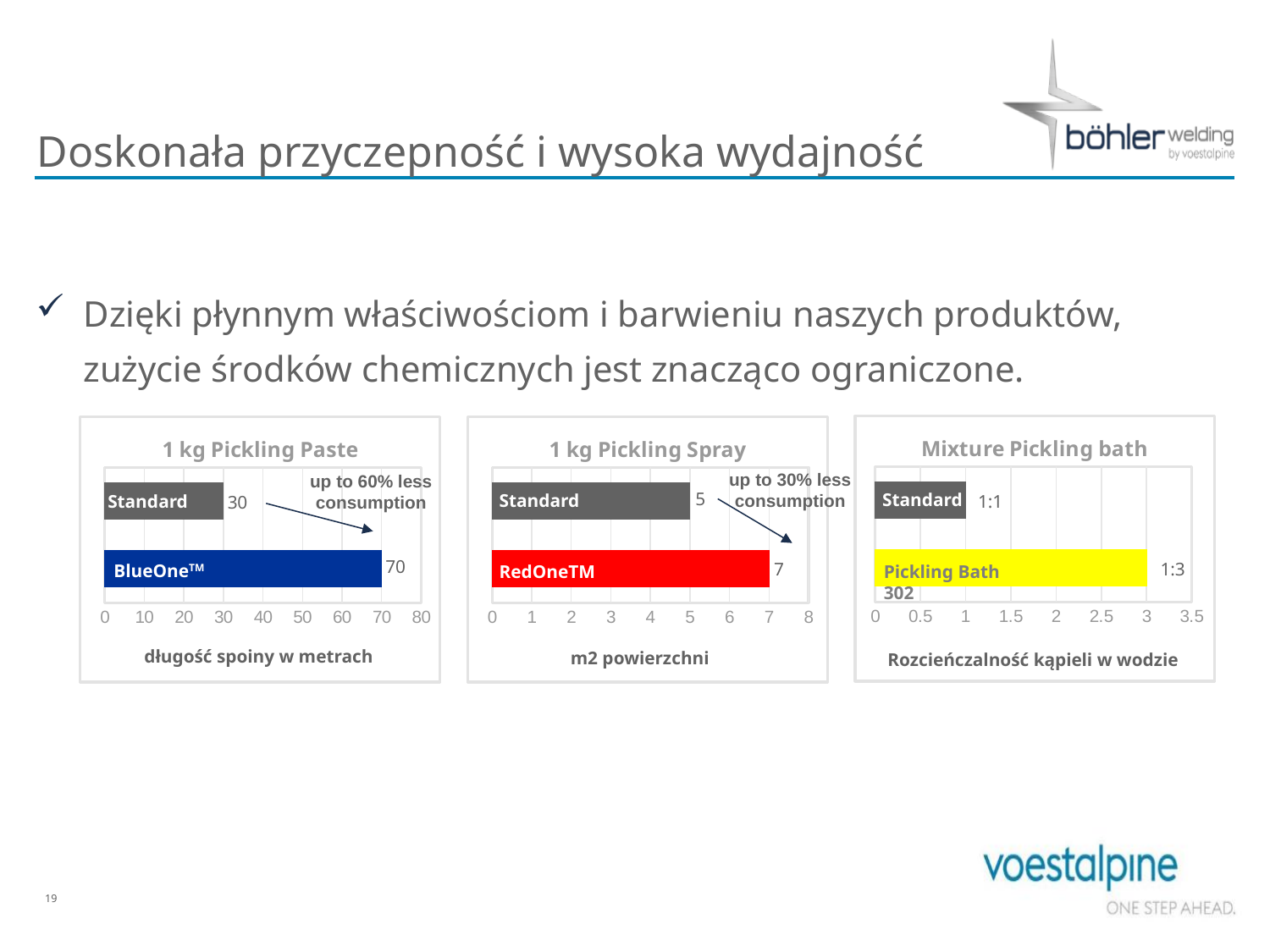
In the '1 kg Pickling Paste' chart, what is the difference between the BlueOne and Standard values? 40 In the '1 kg Pickling Spray' chart, what is the difference between the RedOne and Standard values? 2 In the '1 kg Pickling Spray' chart, which category has the lower value? Standard In the 'Mixture Pickling bath' chart, what is the value label for Standard? 1:1 How many charts are shown on the slide? 3 In the '1 kg Pickling Spray' chart, what is the value for Standard? 5 What type of chart is the '1 kg Pickling Paste' chart? Bar chart In the 'Mixture Pickling bath' chart, what is the value label for Pickling Bath 302? 1:3 In the '1 kg Pickling Paste' chart, which category has the higher value? BlueOne In the '1 kg Pickling Paste' chart, what is the value for Standard? 30 In the '1 kg Pickling Paste' chart, what is the value for BlueOne? 70 In the '1 kg Pickling Spray' chart, what is the value for RedOne? 7